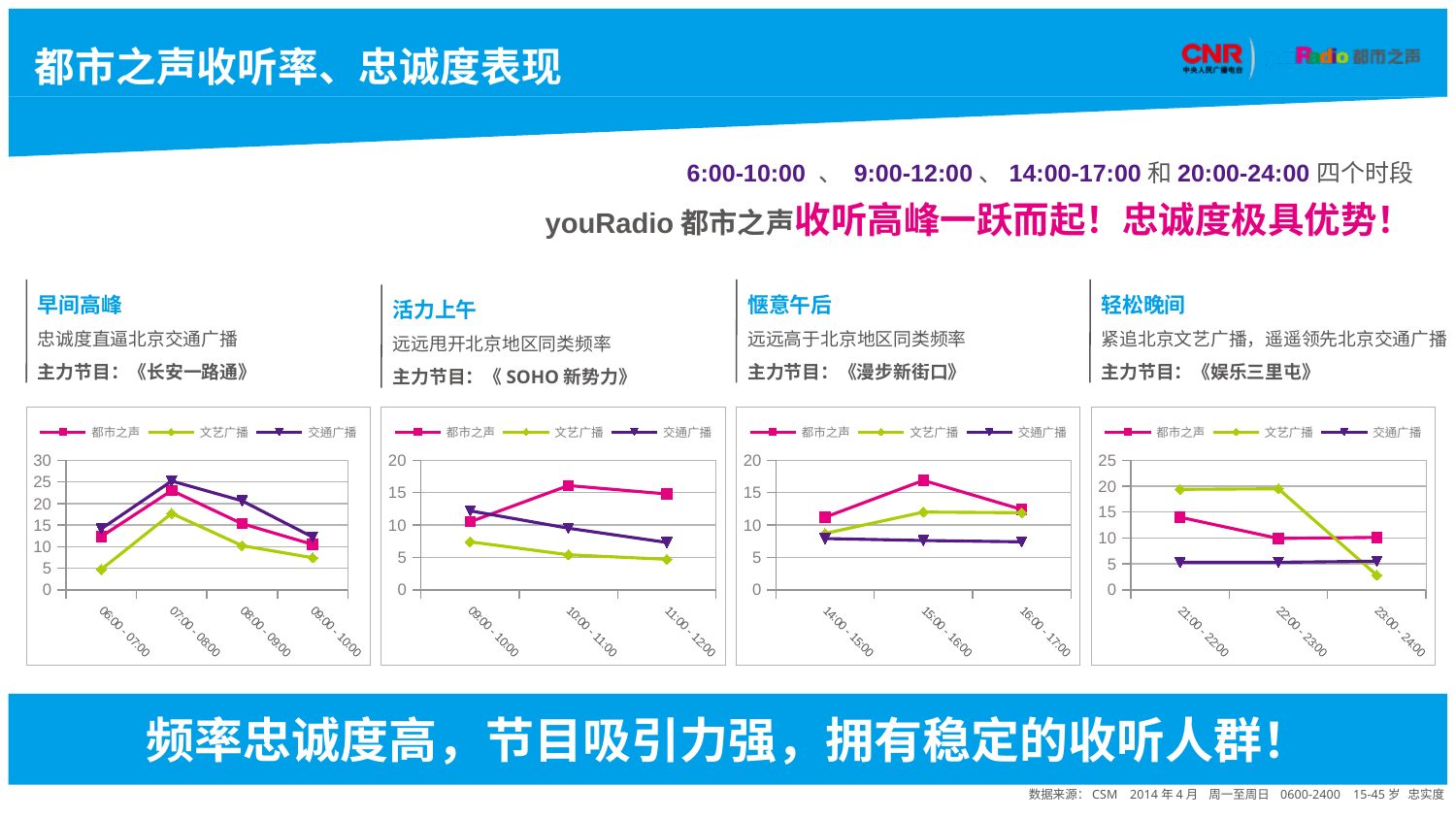
In the 轻松晚间 chart, is the value for 文艺广播 at 23:00-24:00 greater or less than 5? less In the 惬意午后 chart, which is larger at 15:00-16:00: 都市之声 or 交通广播? 都市之声 In the 轻松晚间 chart, which series has the highest value at 21:00-22:00? 文艺广播 In the 惬意午后 chart, is the value for 都市之声 at 15:00-16:00 greater or less than 15? greater How many time slots are plotted on the x axis of the 活力上午 chart? 3 How many time slots are plotted on the x axis of the 早间高峰 chart? 4 How many series does the legend of the 早间高峰 chart list? 3 In the 活力上午 chart, does the 文艺广播 line rise or fall from 09:00-10:00 to 11:00-12:00? fall In the 早间高峰 chart, is the value for 交通广播 at 07:00-08:00 greater or less than 20? greater In the 活力上午 chart, at which time slot does 都市之声 reach its highest value? 10:00 - 11:00 What type of chart is the first (leftmost) chart, titled 早间高峰? line chart